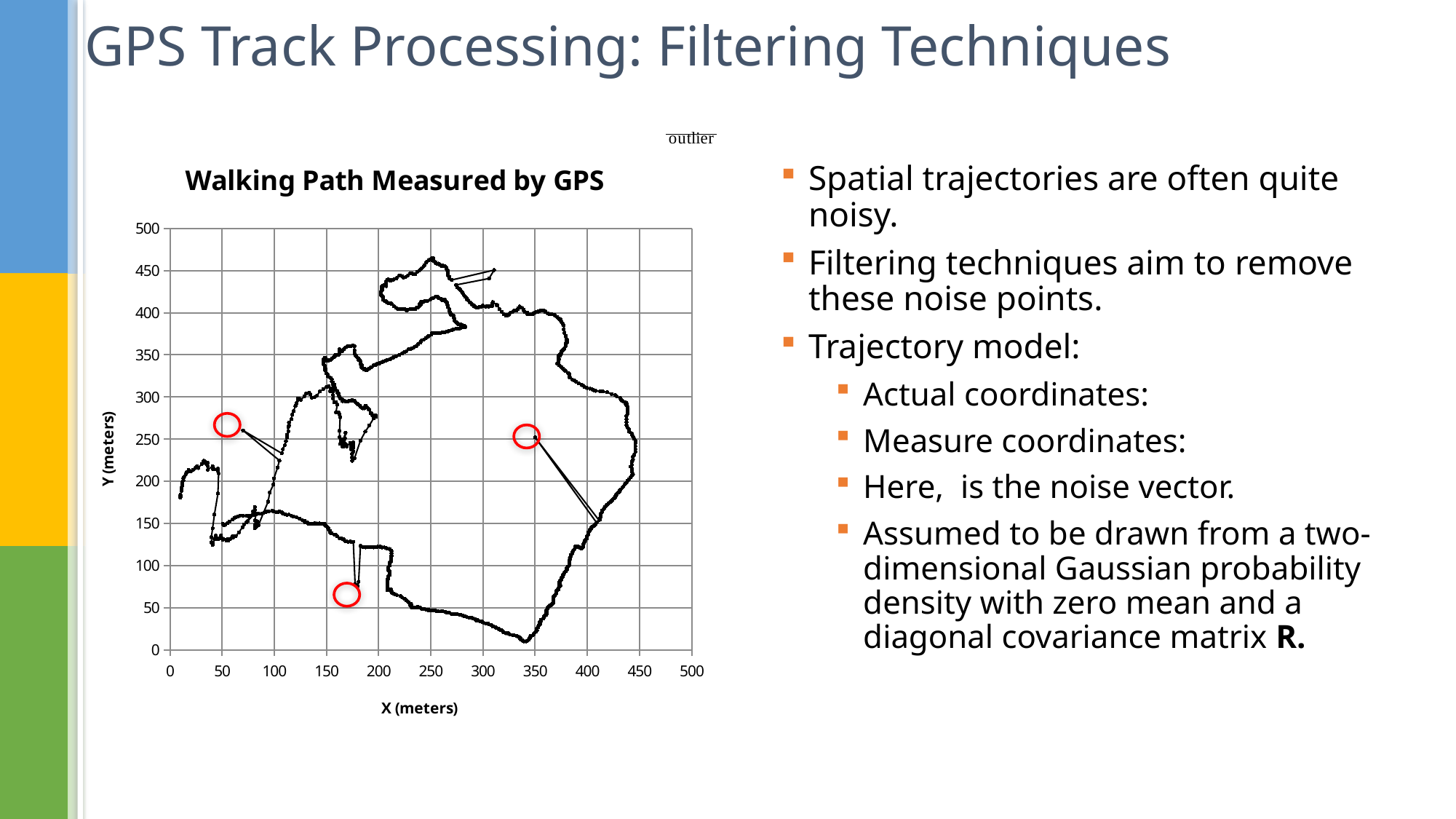
What is the interval between consecutive tick marks on the X (meters) axis of the chart? 50 Is the highest Y value reached by the walking path greater or less than 450? greater Is the Y value of the red-circled outlier at the bottom of the chart (near X = 170) greater or less than 100? less What kind of chart is shown on the slide? scatter chart Is the X value of the red-circled outlier at the bottom of the chart greater or less than 150? greater What is the label of the horizontal axis of the chart? X (meters) What is the maximum value shown on the Y (meters) axis of the chart? 500 How many red circles marking outliers are drawn on the chart? 3 What is the title of the chart on the slide? Walking Path Measured by GPS